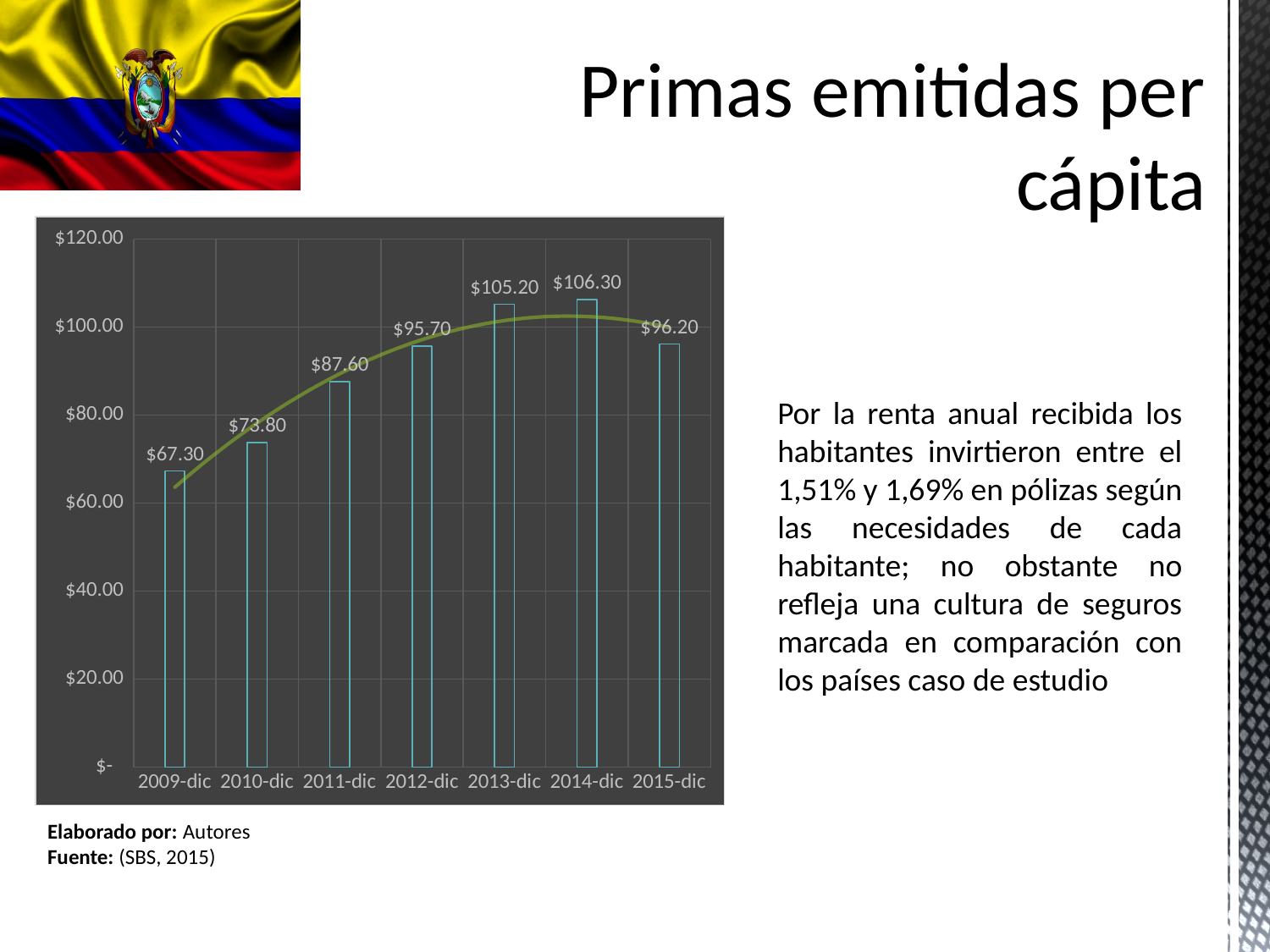
How many years are shown on the x axis? 7 What is the value for 2015-dic? $96.20 Which is larger, the value for 2013-dic or the value for 2015-dic? 2013-dic What is the value for 2009-dic? $67.30 What is the value for 2012-dic? $95.70 Is the value for 2011-dic greater or less than $80.00? greater Which year has the lowest value? 2009-dic Do the values rise or fall from 2009-dic to 2014-dic? rise What is the difference between the values for 2014-dic and 2009-dic? $39.00 What is the difference between the values for 2011-dic and 2010-dic? $13.80 What kind of chart is shown on the slide? bar chart Which year has the highest value? 2014-dic